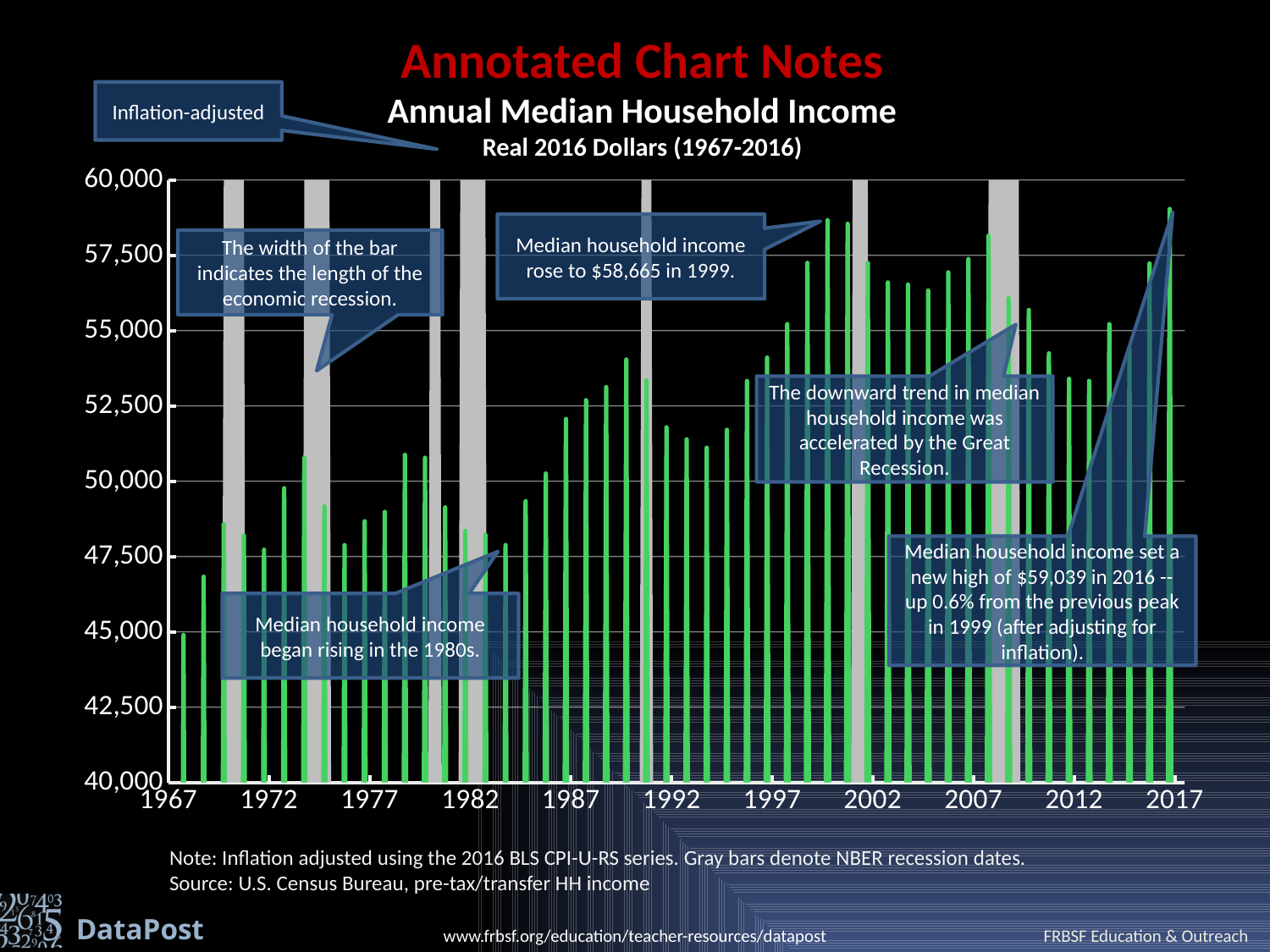
By how much does the 2016 median household income ($59,039) exceed the 1999 value ($58,665)? $374 Which year has the larger median household income, 1999 or 2016? 2016 What kind of chart is shown on the slide? bar chart Is the median household income for 1989 greater or less than 52,500? greater According to the annotation, what new high did median household income reach in 2016? $59,039 Is the median household income for 1982 greater or less than 50,000? less According to the annotation, what was median household income in 1999? $58,665 Which year has the highest median household income on the chart? 2016 What is the title of the chart? Annual Median Household Income According to the note, what do the gray bars on the chart denote? NBER recession dates Does median household income generally rise or fall from 1967 to 1999? rise Which year has the lowest median household income on the chart? 1967